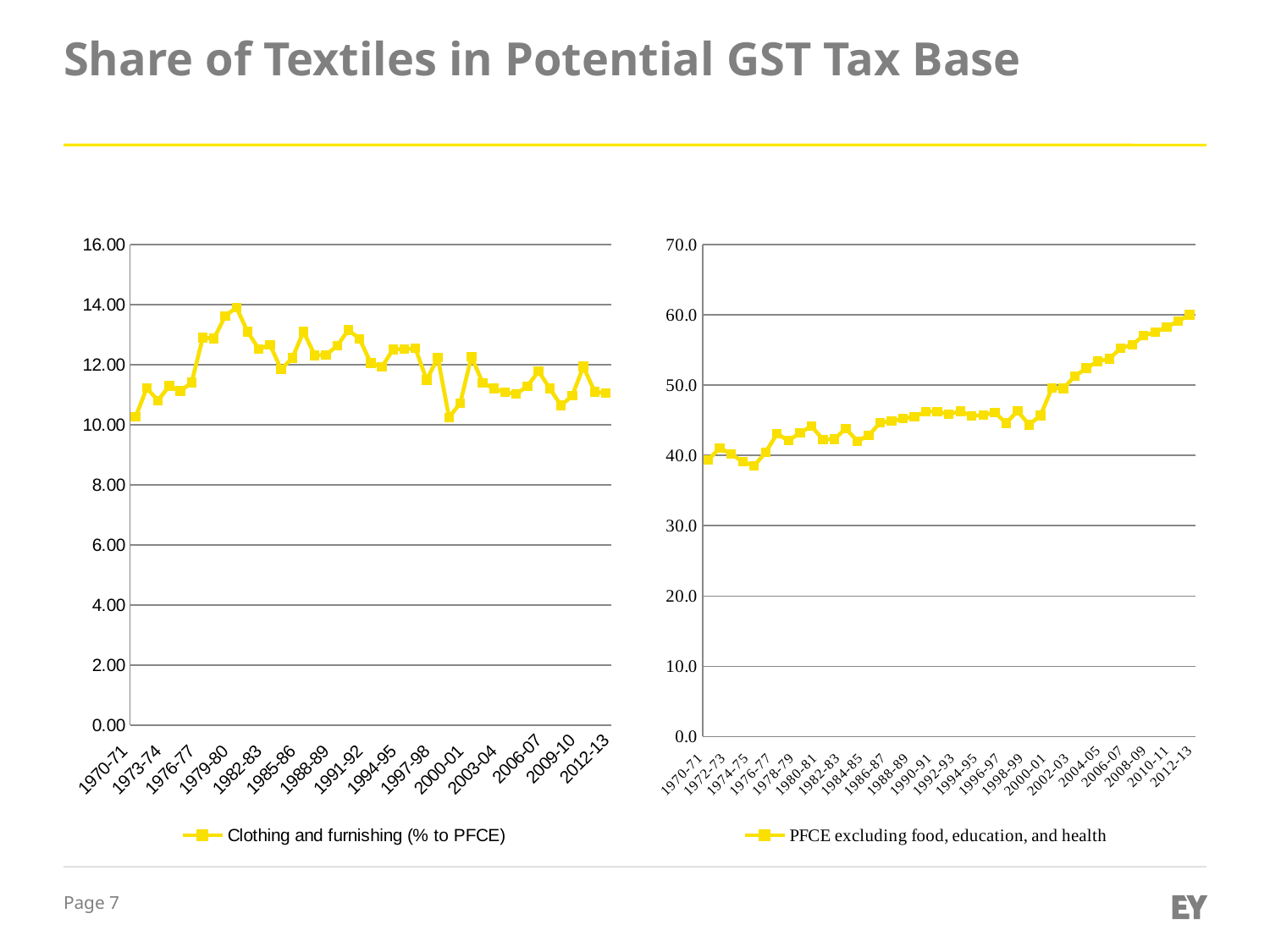
In the left chart (Clothing and furnishing), is the value for 1979-80 greater or less than 12.00? greater What kind of chart is the right chart on the slide? line chart In the right chart (PFCE excluding food, education, and health), do the values generally rise or fall from 1970-71 to 2012-13? rise How many series does the legend of the left chart list? 1 In the right chart (PFCE excluding food, education, and health), which year has the highest value? 2012-13 In the left chart (Clothing and furnishing), which year has the highest value? 1979-80 In the right chart (PFCE excluding food, education, and health), is the value for 2012-13 greater or less than 50.0? greater In the left chart (Clothing and furnishing), is the value for 2000-01 greater or less than 12.00? greater In the left chart, what is the name of the series shown in the legend? Clothing and furnishing (% to PFCE) What kind of chart is the left chart on the slide? line chart In the right chart, what is the name of the series shown in the legend? PFCE excluding food, education, and health